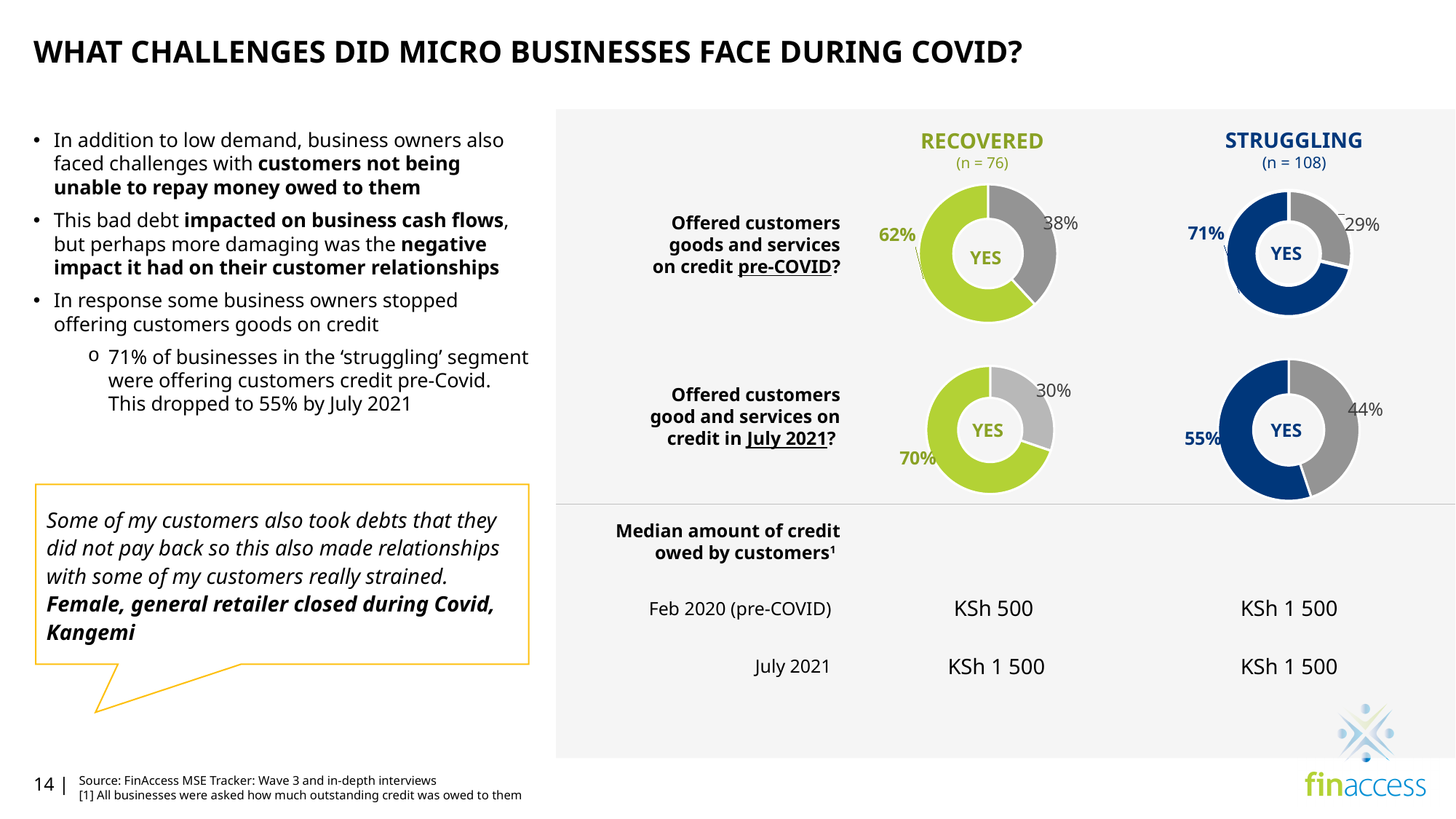
In the Struggling pre-COVID donut chart, what share is shown for the non-YES (grey) segment? 29% What is the sample size (n) shown for the Struggling segment? 108 What kind of chart is used to show the share of businesses offering credit? Donut (pie) chart In the Recovered pre-COVID donut chart, what share of businesses offered customers goods and services on credit (YES)? 62% Which segment had the larger YES share for offering credit in July 2021, Recovered or Struggling? Recovered In the Recovered July 2021 donut chart, what share of businesses offered customers goods and services on credit (YES)? 70% In the Struggling July 2021 donut chart, what share of businesses offered customers goods and services on credit (YES)? 55% What is the difference between the YES shares of the Recovered and Struggling segments in the pre-COVID donut charts? 9 percentage points By how many percentage points did the Struggling segment's YES share for offering credit fall from pre-COVID to July 2021? 16 percentage points In the Struggling pre-COVID donut chart, what share of businesses offered customers goods and services on credit (YES)? 71% Which segment had the larger YES share for offering credit pre-COVID, Recovered or Struggling? Struggling In the Recovered July 2021 donut chart, what share is shown for the non-YES (grey) segment? 30%